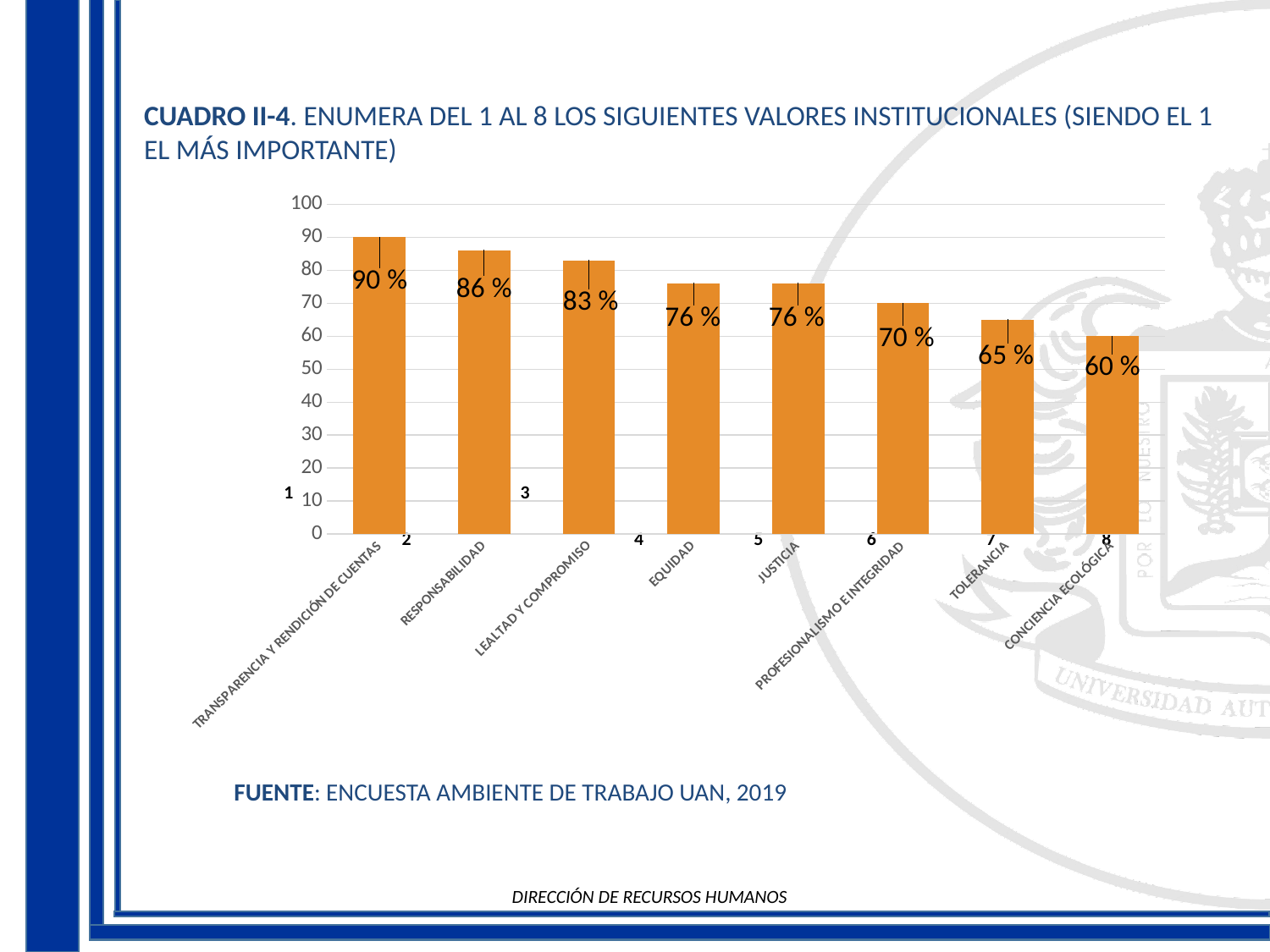
How many categories are shown in the chart? 8 What is the value for LEALTAD Y COMPROMISO? 83 % Do the values rise or fall from left to right along the x axis? fall Which is larger, the value for EQUIDAD or the value for TOLERANCIA? EQUIDAD Is the value for CONCIENCIA ECOLÓGICA greater or less than 70? less Which category has the highest value? TRANSPARENCIA Y RENDICIÓN DE CUENTAS What is the value for TRANSPARENCIA Y RENDICIÓN DE CUENTAS? 90 % What kind of chart is shown on the slide? bar chart What is the value for TOLERANCIA? 65 % What is the difference between the values for RESPONSABILIDAD and PROFESIONALISMO E INTEGRIDAD? 16 % What is the value for RESPONSABILIDAD? 86 % Which category has the lowest value? CONCIENCIA ECOLÓGICA